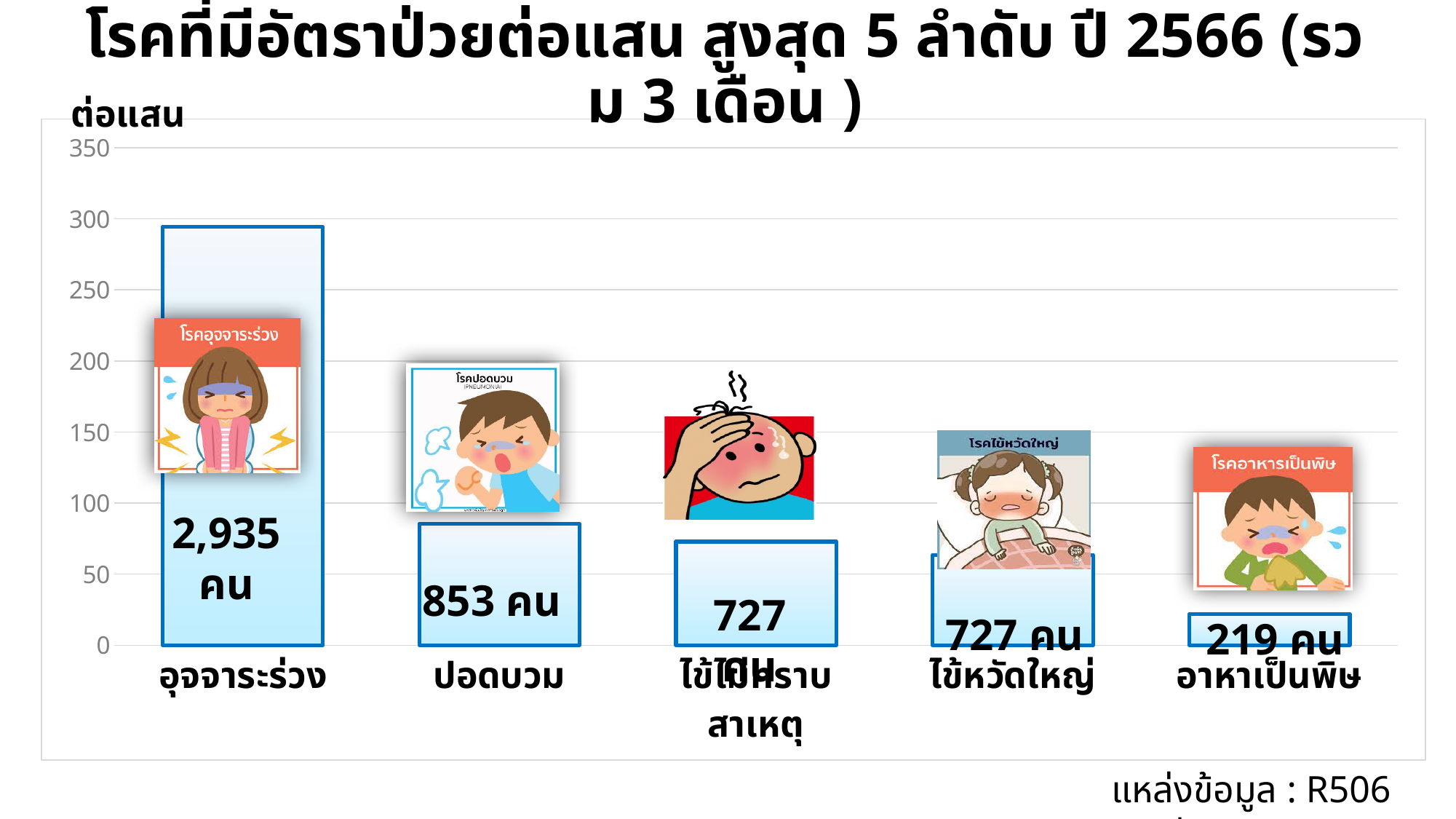
What case count is printed on the bar for อาหาเป็นพิษ? 219 คน Do the bar heights rise or fall from left to right across the chart? fall Which bar is taller, ปอดบวม or ไข้หวัดใหญ่? ปอดบวม Is the bar for ปอดบวม greater or less than 100 on the axis? less What case count is printed on the bar for อุจจาระร่วง? 2,935 คน How many disease categories are plotted on the chart? 5 What kind of chart is shown on the slide? bar chart What case count is printed on the bar for ปอดบวม? 853 คน Which disease has the highest bar on the chart? อุจจาระร่วง Is the bar for อุจจาระร่วง greater or less than 300 on the axis? less What is the difference between the case counts printed for อุจจาระร่วง and ปอดบวม? 2,082 คน Which disease has the lowest bar on the chart? อาหาเป็นพิษ